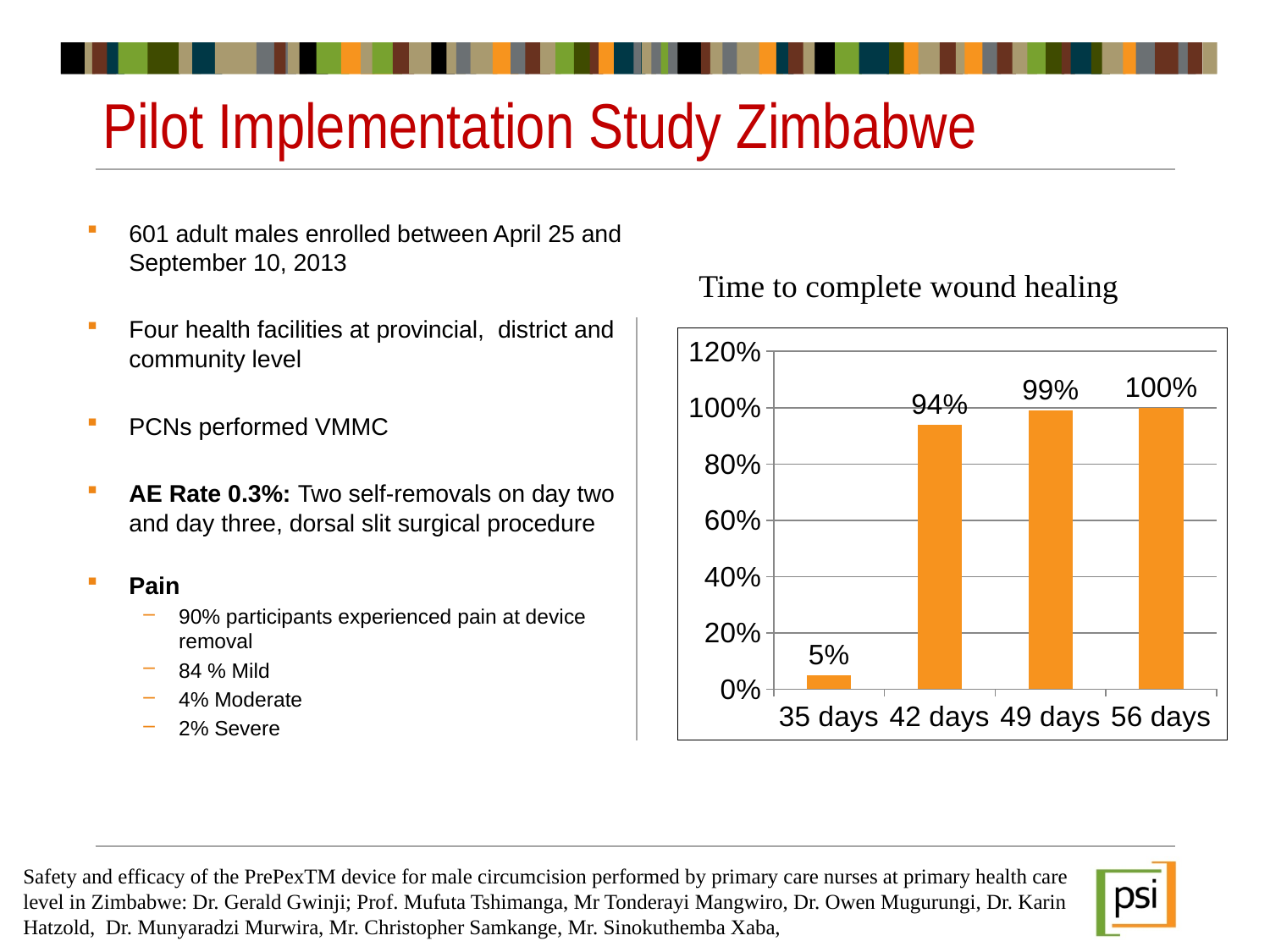
What is the value for 49 days in the 'Time to complete wound healing' chart? 99% Which is larger in the 'Time to complete wound healing' chart, the value for 42 days or the value for 35 days? 42 days What is the difference between the values for 42 days and 35 days in the 'Time to complete wound healing' chart? 89% Which category has the highest value in the 'Time to complete wound healing' chart? 56 days Do the values in the 'Time to complete wound healing' chart rise or fall from 35 days to 56 days? rise Which category has the lowest value in the 'Time to complete wound healing' chart? 35 days What is the value for 35 days in the 'Time to complete wound healing' chart? 5% How many categories are shown on the x axis of the 'Time to complete wound healing' chart? 4 Is the value for 42 days greater or less than 80% in the 'Time to complete wound healing' chart? greater What is the value for 56 days in the 'Time to complete wound healing' chart? 100% What kind of chart is the 'Time to complete wound healing' chart? bar chart What is the value for 42 days in the 'Time to complete wound healing' chart? 94%